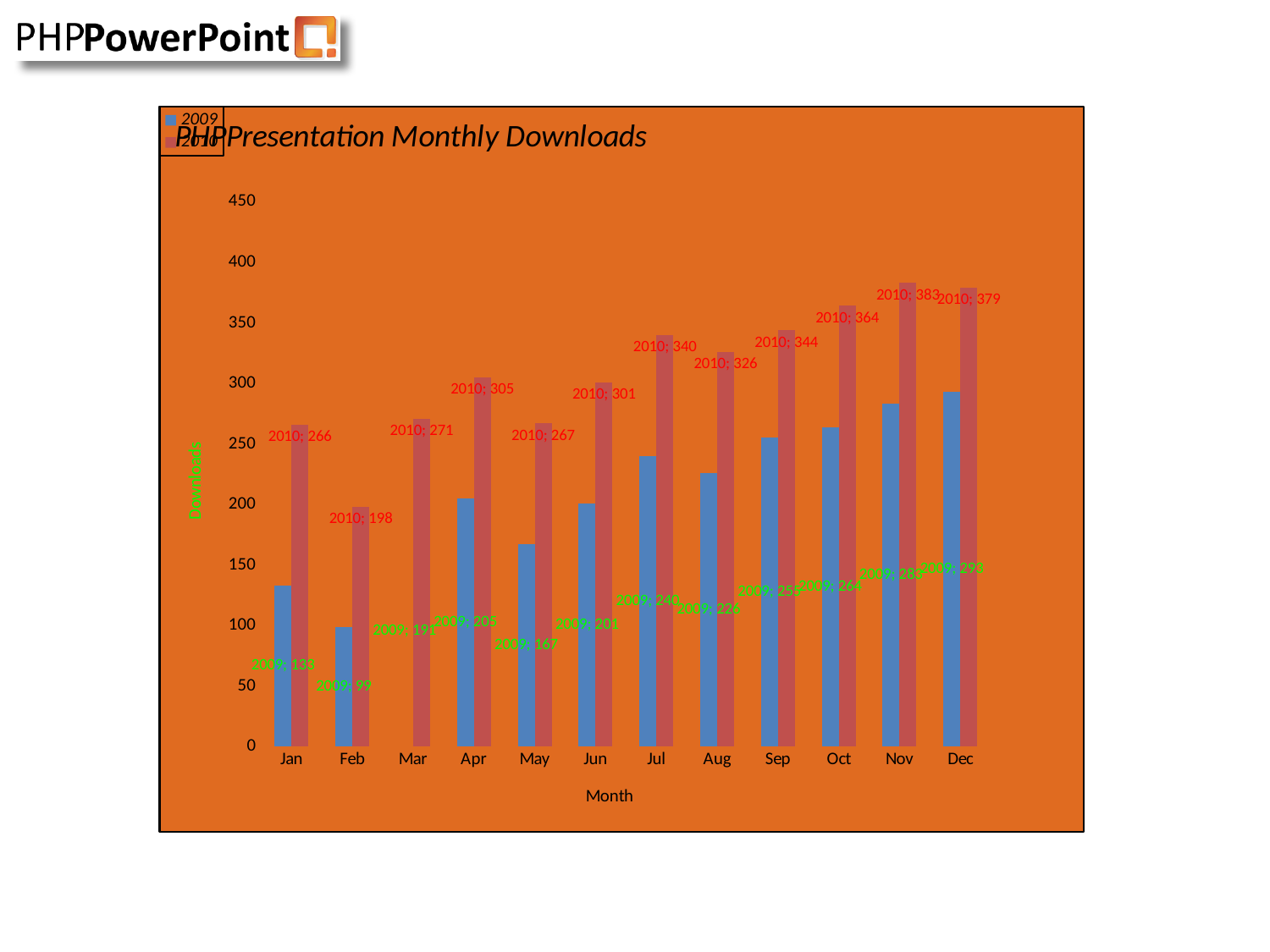
Is the 2009 downloads value for Jul greater or less than 200? greater What is the 2009 downloads value for Feb? 99 How many series does the legend list? 2 How many months are shown on the x axis? 12 What is the title of the chart? PHPPresentation Monthly Downloads What is the difference between the 2010 and 2009 downloads for Dec? 86 Which month has the lowest 2009 downloads? Feb Which month has the highest 2010 downloads? Nov Which is larger, the 2010 downloads for Jul or for Aug? Jul What is the 2010 downloads value for Nov? 383 What is the 2010 downloads value for Apr? 305 What kind of chart is shown on the slide? bar chart